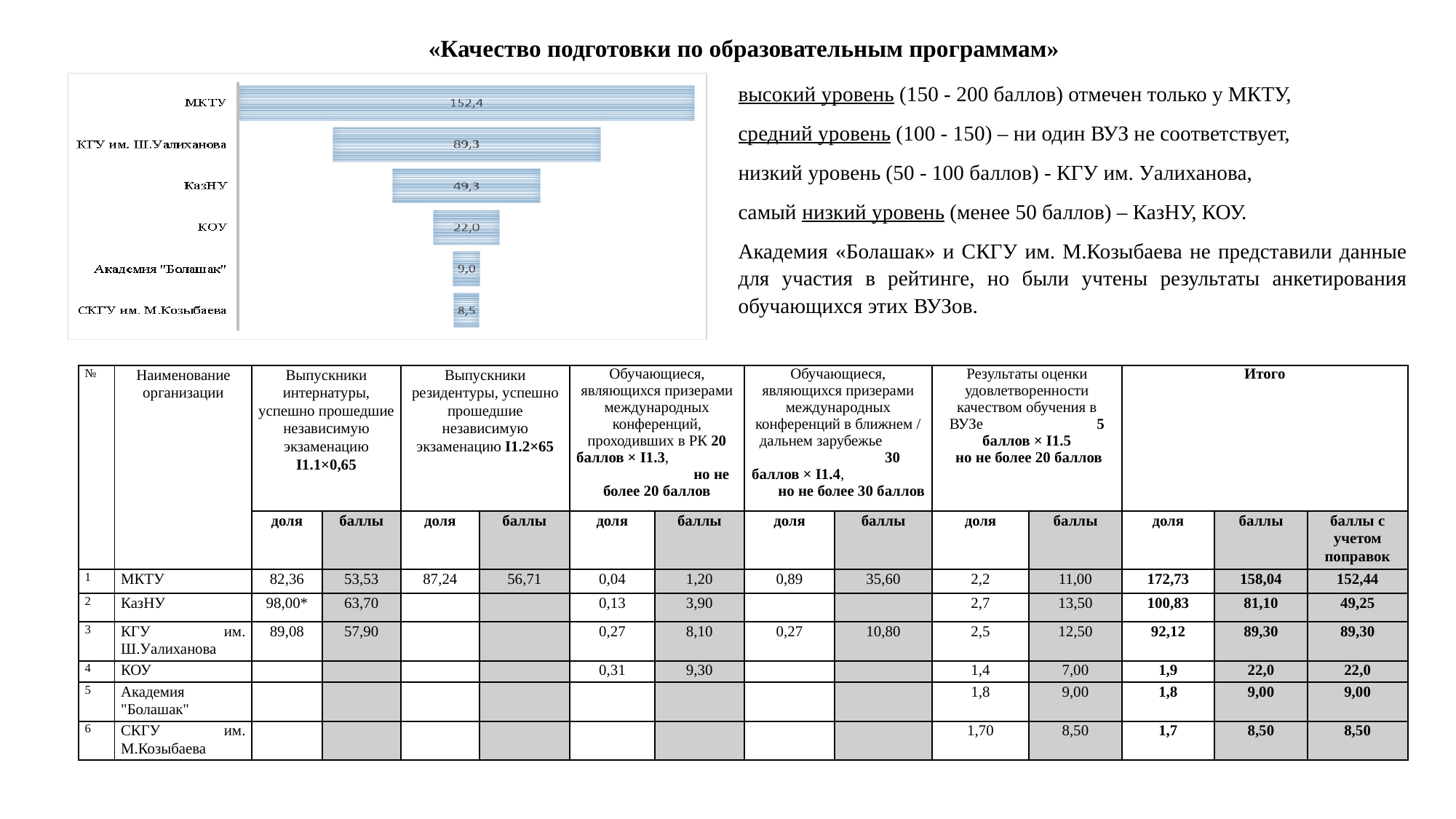
Which has a larger value in the chart, КазНУ or КОУ? КазНУ What value is shown for КОУ in the chart? 22,0 What value is shown for СКГУ им. М.Козыбаева in the chart? 8,5 Which organisation has the lowest value in the chart? СКГУ им. М.Козыбаева How many organisations are shown in the chart? 6 What value is shown for КГУ им. Ш.Уалиханова in the chart? 89,3 What kind of chart is shown on the slide? Bar chart Which organisation has the highest value in the chart? МКТУ What is the difference between the values for МКТУ and КГУ им. Ш.Уалиханова in the chart? 63,1 What value is shown for МКТУ in the chart? 152,4 What value is shown for КазНУ in the chart? 49,3 What is the difference between the values for Академия "Болашак" and СКГУ им. М.Козыбаева in the chart? 0,5